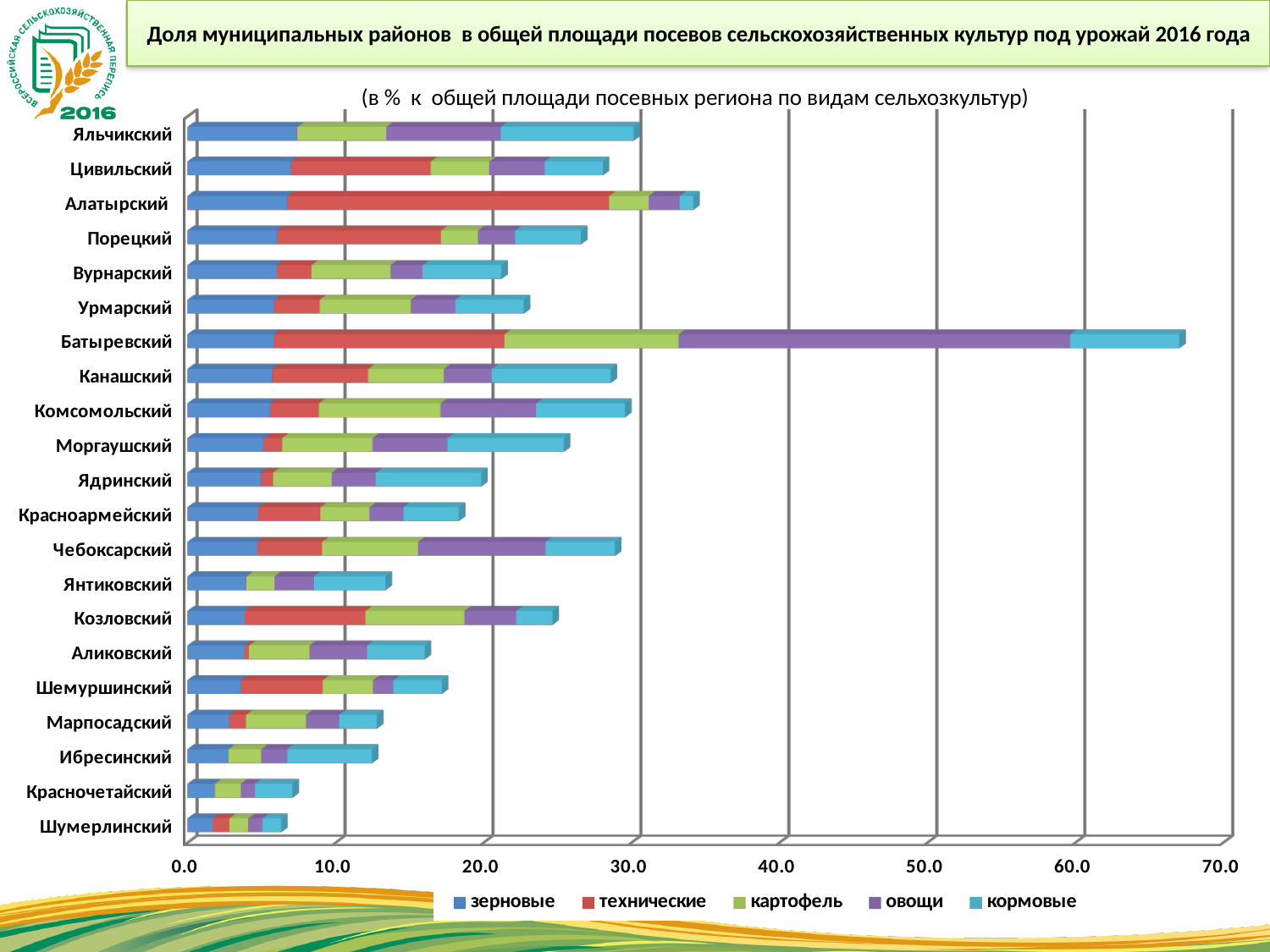
Which crop category makes up the largest segment of the Батыревский bar? овощи What are the five series listed in the legend? зерновые, технические, картофель, овощи, кормовые How many series does the legend list? 5 How many municipal districts are plotted on the chart? 21 Which has the larger total, Козловский or Аликовский? Козловский Is the total value for Яльчикский greater or less than 20.0? greater What is the highest value shown on the horizontal axis? 70.0 What kind of chart is shown on the slide? stacked bar chart Which district has the largest total share of sown area? Батыревский Is the total value for Батыревский greater or less than 60.0? greater Is the total value for Янтиковский greater or less than 20.0? less Which has the larger total, Алатырский or Порецкий? Алатырский